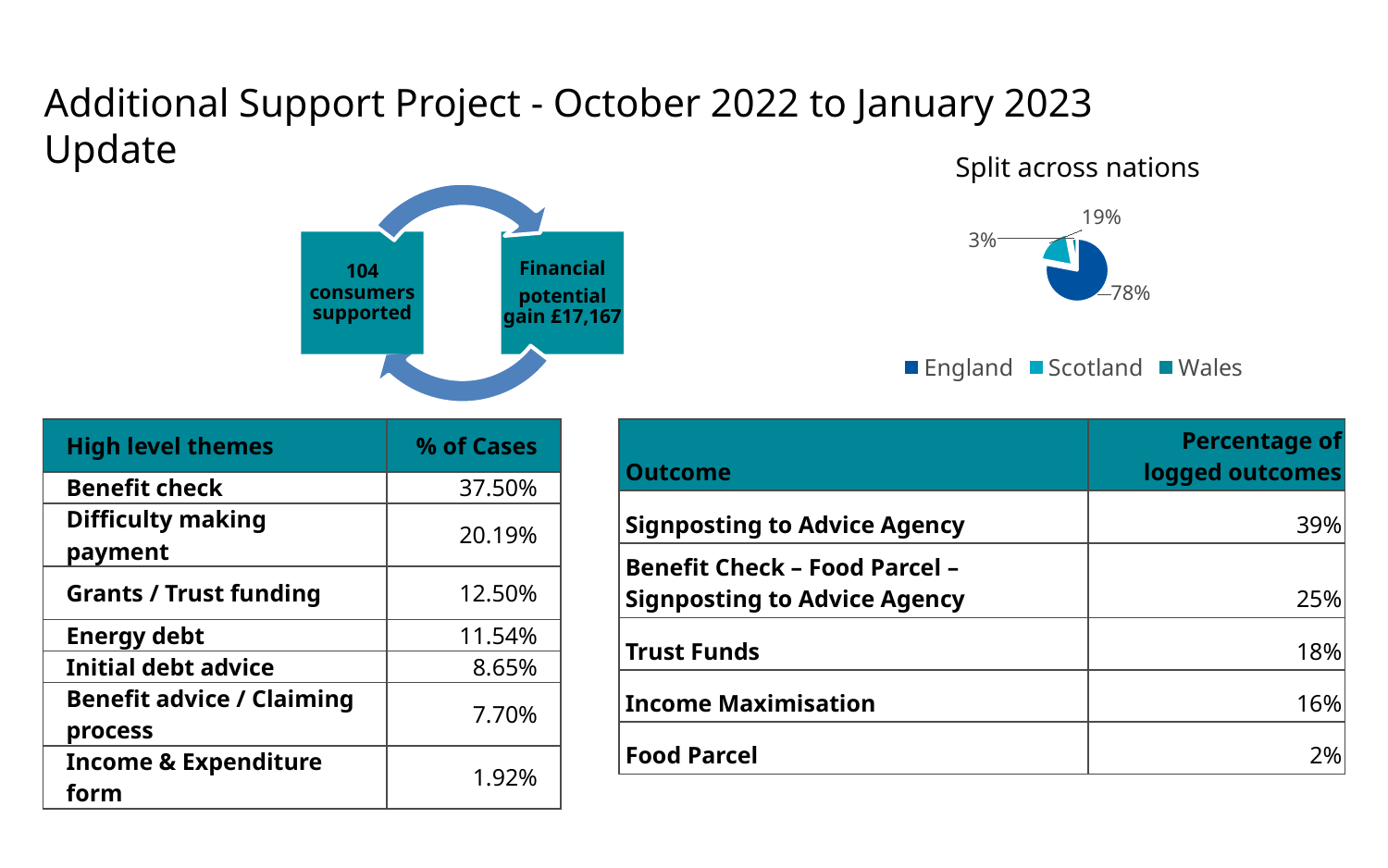
How many nations are shown in the "Split across nations" pie chart? 3 In the "Split across nations" pie chart, what percentage is shown for England? 78% In the "Split across nations" pie chart, which nation has the largest share? England In the "Split across nations" pie chart, what percentage is shown for Wales? 3% In the "Split across nations" pie chart, which nation has the smallest share? Wales In the "Split across nations" pie chart, what is the difference in percentage points between Scotland and Wales? 16 In the "Split across nations" pie chart, what percentage is shown for Scotland? 19% In the "Split across nations" pie chart, what is the difference in percentage points between England and Scotland? 59 What type of chart is shown under the title "Split across nations"? pie chart How many entries does the legend of the "Split across nations" pie chart list? 3 What is the title of the pie chart on the slide? Split across nations In the "Split across nations" pie chart, which has the larger share, Scotland or Wales? Scotland